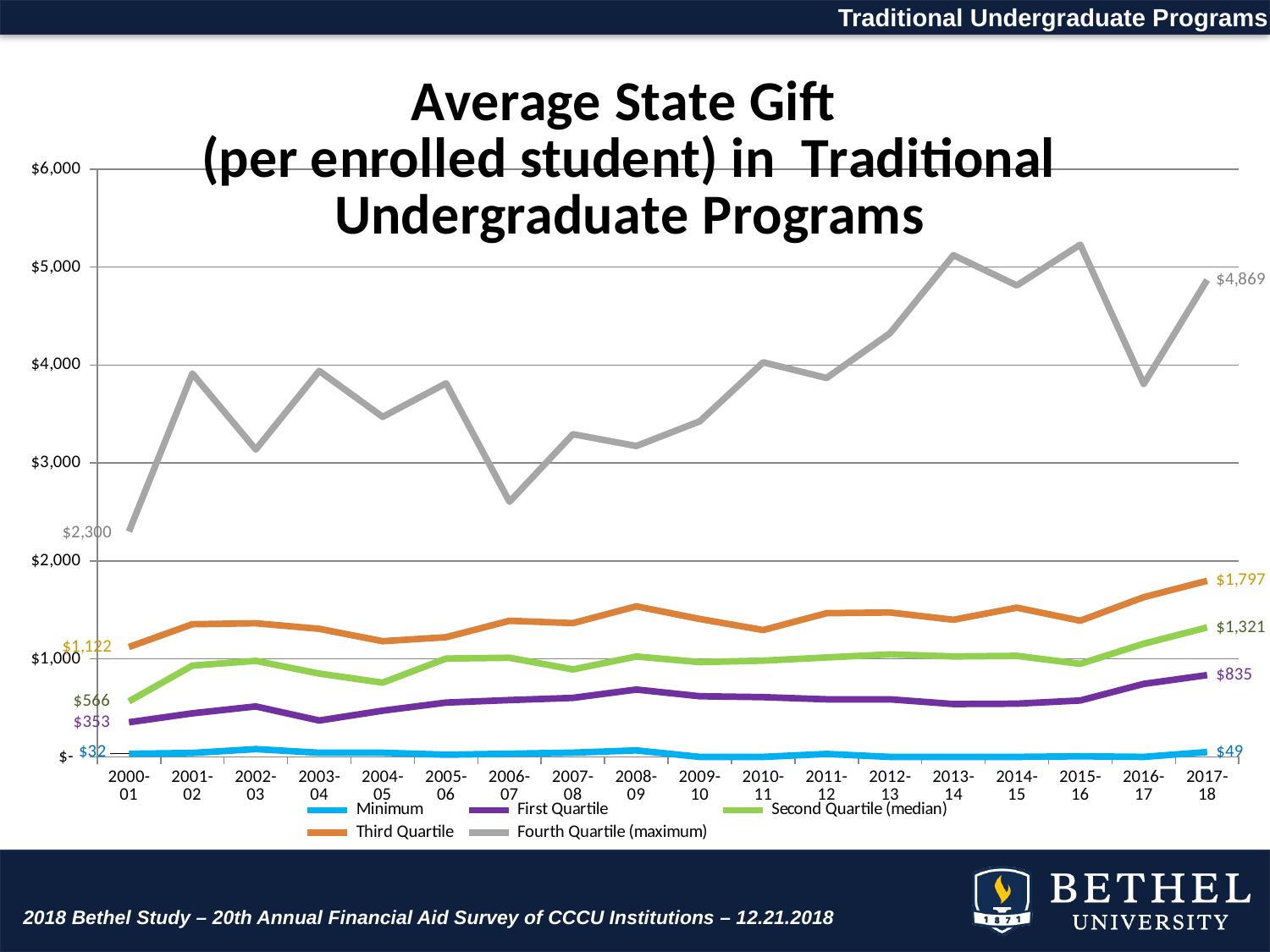
Does the Third Quartile series rise or fall from 2000-01 to 2017-18? rise How many series does the legend list? 5 What is the value of the Third Quartile series in 2000-01? $1,122 Is the Fourth Quartile (maximum) value in 2013-14 greater or less than $5,000? greater What is the value of the Fourth Quartile (maximum) series in 2017-18? $4,869 What is the difference between the First Quartile values in 2017-18 and 2000-01? $482 Which series has the highest value in 2017-18? Fourth Quartile (maximum) What kind of chart is shown on the slide? line chart What is the value of the Second Quartile (median) series in 2000-01? $566 What is the value of the Minimum series in 2017-18? $49 What is the difference between the Fourth Quartile (maximum) values in 2017-18 and 2000-01? $2,569 How many academic years are plotted along the x axis? 18